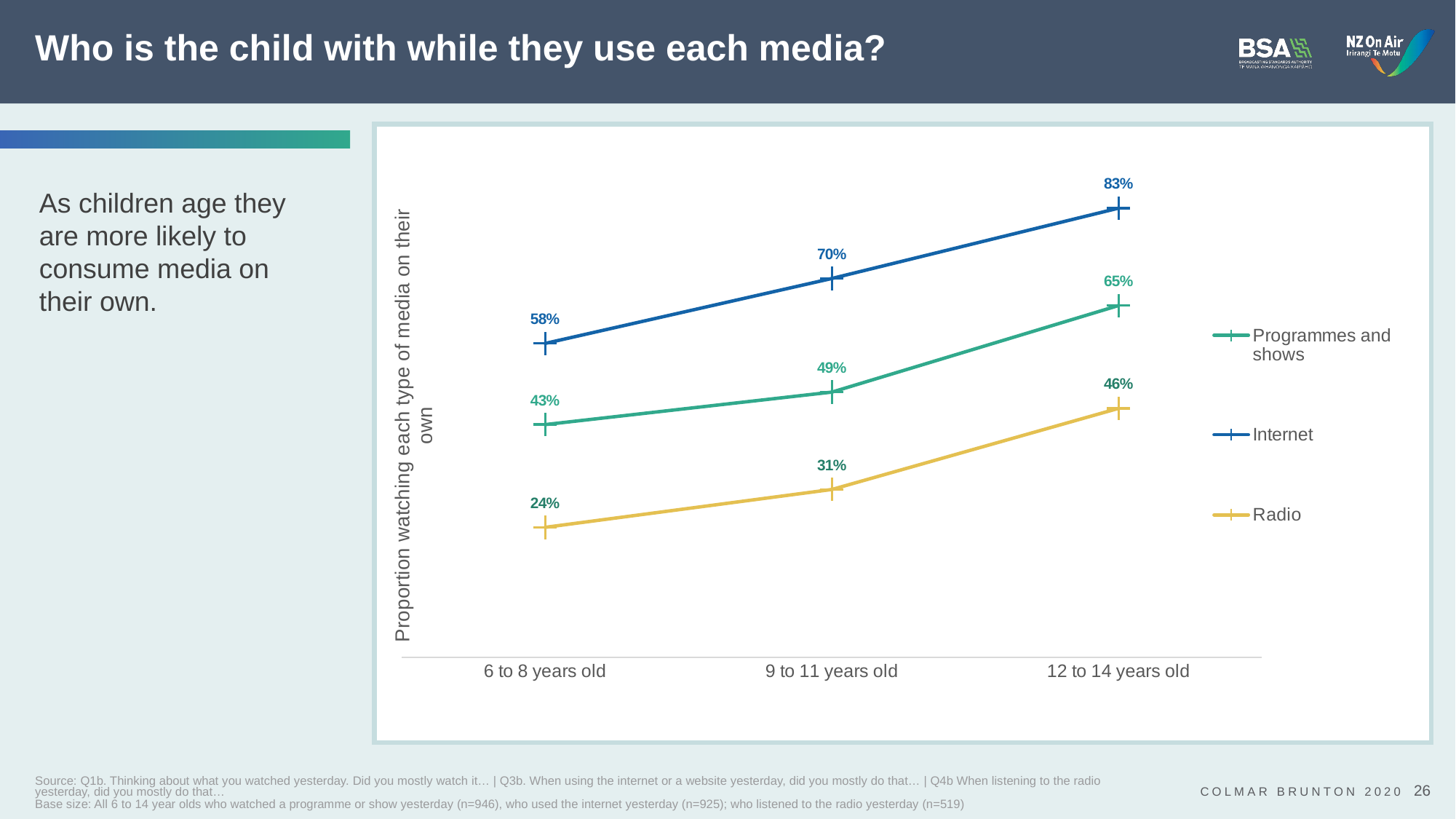
Which is larger among 9 to 11 year olds: Programmes and shows or Radio? Programmes and shows Do the values for Programmes and shows rise or fall as the age group increases? Rise What is the value for Programmes and shows among 9 to 11 year olds? 49% How many age groups are shown on the x axis? 3 What is the y-axis label of the chart? Proportion watching each type of media on their own What is the value for Internet among 12 to 14 year olds? 83% What kind of chart is shown on the slide? Line chart What is the difference between the Internet values for 12 to 14 year olds and 6 to 8 year olds? 25% Which age group has the highest value for Radio? 12 to 14 years old What is the value for Radio among 6 to 8 year olds? 24% Which series has the lowest value among 6 to 8 year olds? Radio How many series does the legend list? 3